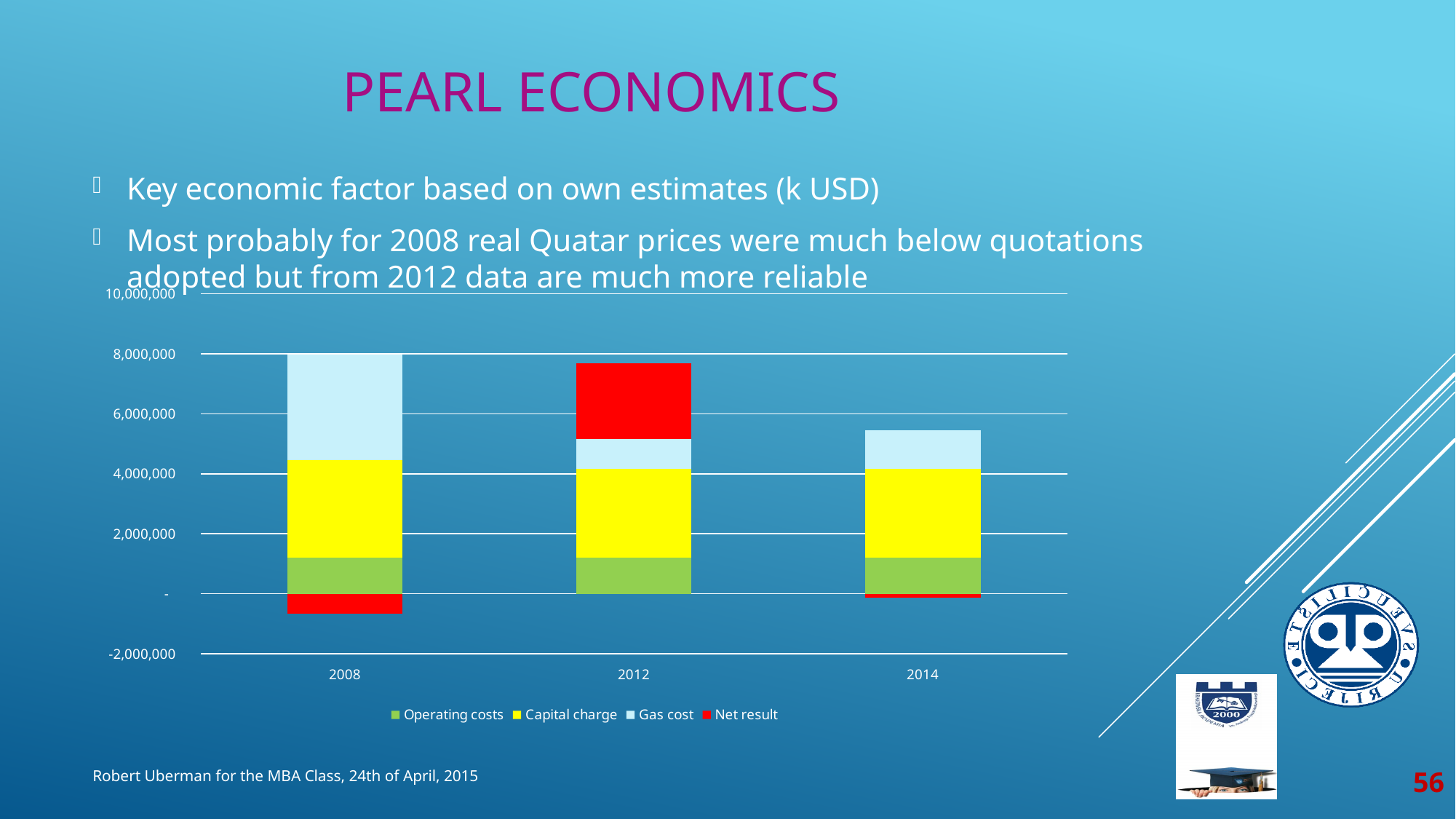
What kind of chart is shown on the slide? Stacked bar chart Which year has the highest Net result in the chart? 2012 How many series does the chart's legend list? 4 Is the top of the stacked bar for 2014 greater or less than 4,000,000? greater Is the Net result for 2008 positive or negative? negative Which year has the lowest Net result in the chart? 2008 Which year has the larger Net result, 2008 or 2012? 2012 How many years (categories) are shown on the x axis of the chart? 3 Is the top of the stacked bar for 2012 greater or less than 8,000,000? less Is the top of the stacked bar for 2014 greater or less than 6,000,000? less Which series is shown in yellow in the chart? Capital charge Which series is shown in red in the chart? Net result